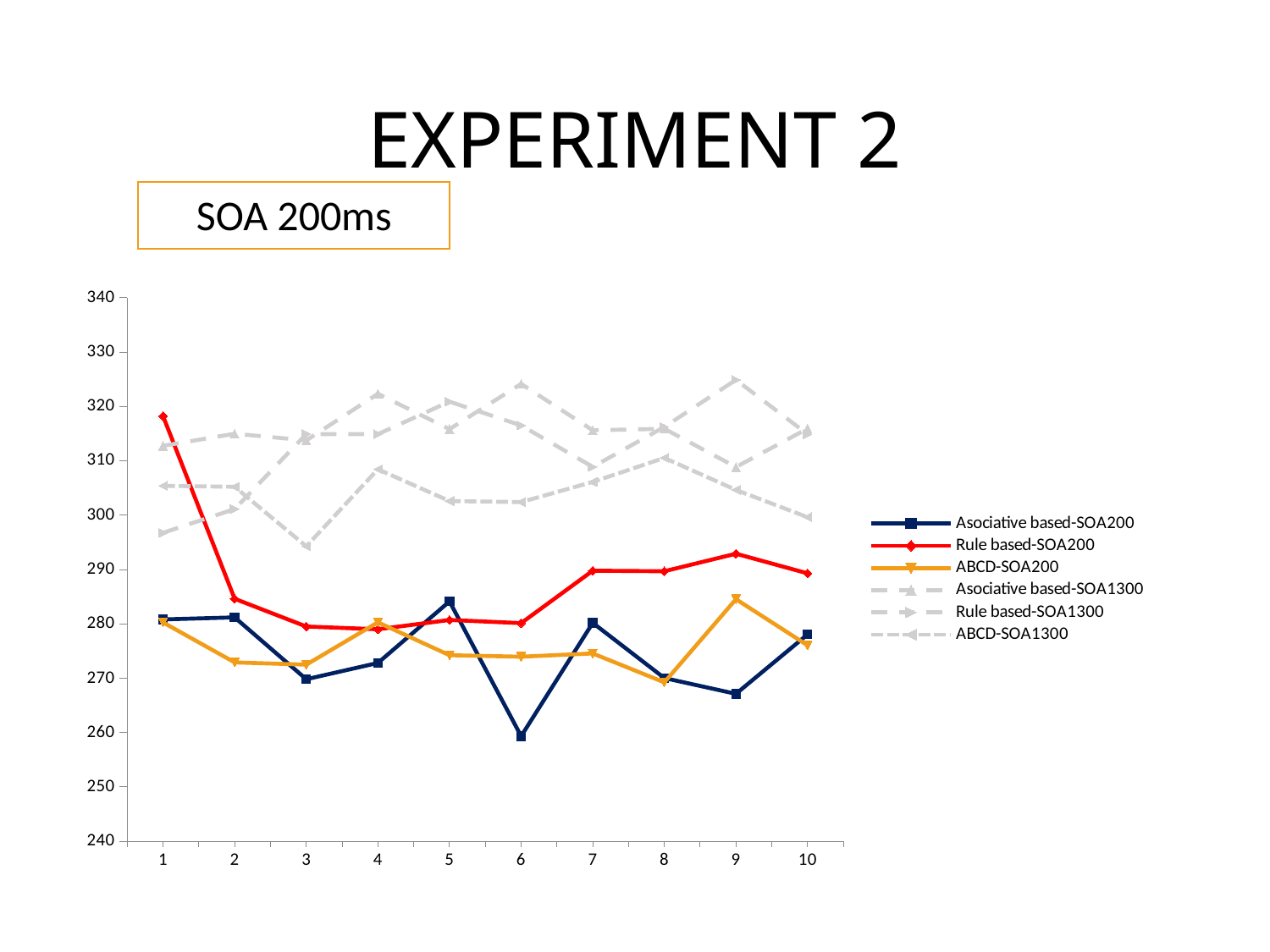
Is the value for Rule based-SOA1300 at point 9 greater or less than 320? greater Which series in the legend are drawn with dashed lines? Asociative based-SOA1300, Rule based-SOA1300, ABCD-SOA1300 How many points are there along the x axis? 10 Is the value for Asociative based-SOA200 at point 6 greater or less than 270? less How many series does the legend list? 6 Is the value for Rule based-SOA200 at point 1 greater or less than 310? greater At point 1, which is larger: Rule based-SOA200 or Asociative based-SOA200? Rule based-SOA200 Does the Rule based-SOA200 series rise or fall from point 1 to point 3? fall At which x-axis point does the Asociative based-SOA200 series reach its lowest value? 6 What kind of chart is shown on the slide? line chart At point 6, which is larger: ABCD-SOA200 or Asociative based-SOA200? ABCD-SOA200